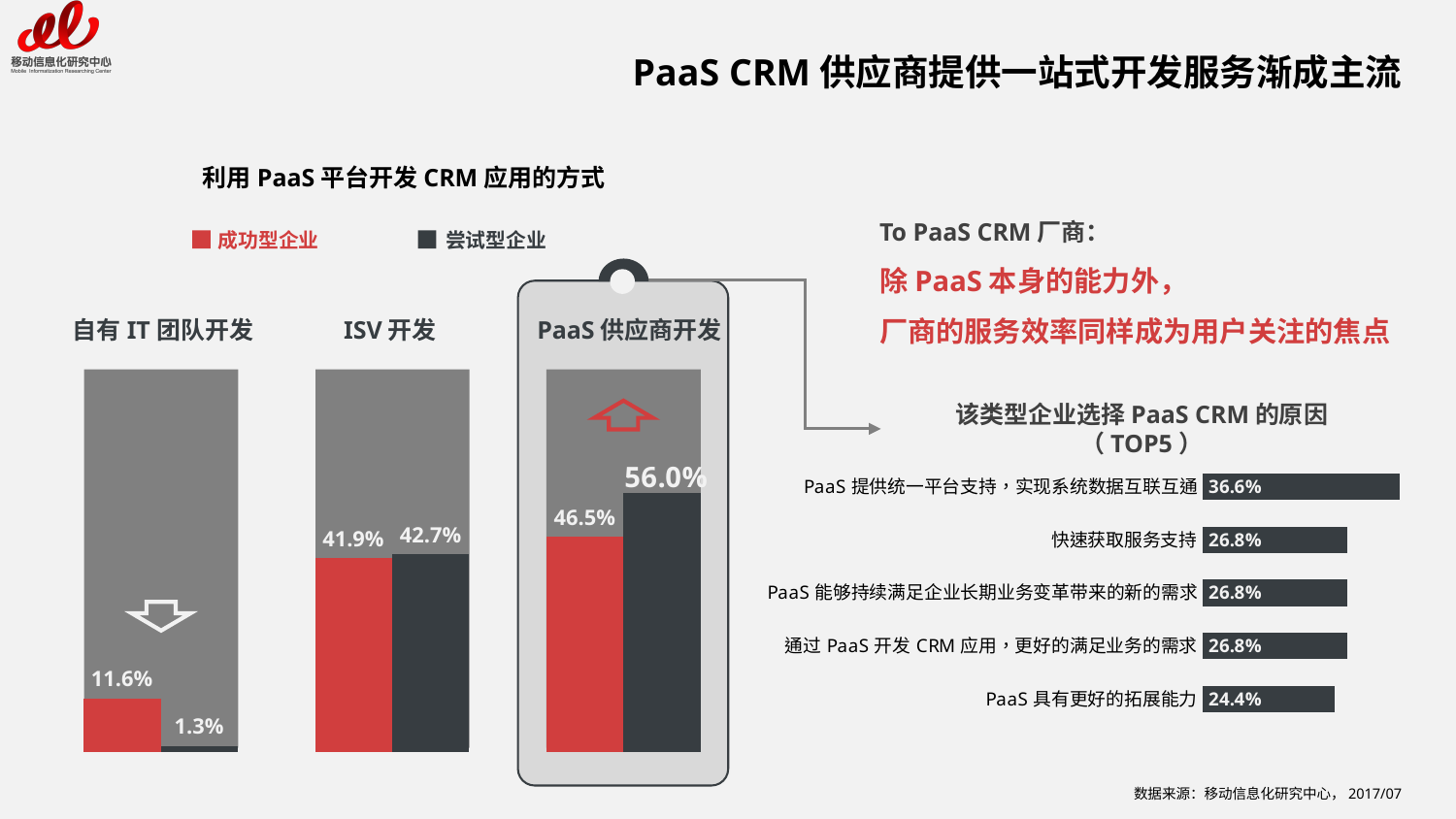
How many reasons are shown in the chart '该类型企业选择 PaaS CRM 的原因（TOP5）'? 5 In the chart '该类型企业选择 PaaS CRM 的原因（TOP5）', what is the difference between the highest value and the lowest value? 12.2% In the chart '利用 PaaS 平台开发 CRM 应用的方式', what is the difference between 尝试型企业 and 成功型企业 under PaaS 供应商开发? 9.5% In the chart '利用 PaaS 平台开发 CRM 应用的方式', what is the value for 尝试型企业 under ISV 开发? 42.7% In the chart '利用 PaaS 平台开发 CRM 应用的方式', what is the value for 成功型企业 under 自有 IT 团队开发? 11.6% In the chart '利用 PaaS 平台开发 CRM 应用的方式', which development method has the lowest value for 尝试型企业? 自有 IT 团队开发 How many series does the legend of the chart '利用 PaaS 平台开发 CRM 应用的方式' list? 2 In the chart '该类型企业选择 PaaS CRM 的原因（TOP5）', what is the value for 'PaaS 提供统一平台支持，实现系统数据互联互通'? 36.6% What kind of chart is '利用 PaaS 平台开发 CRM 应用的方式'? Bar chart In the chart '利用 PaaS 平台开发 CRM 应用的方式', which is larger under 自有 IT 团队开发: 成功型企业 or 尝试型企业? 成功型企业 In the chart '该类型企业选择 PaaS CRM 的原因（TOP5）', which reason has the lowest value? PaaS 具有更好的拓展能力 In the chart '利用 PaaS 平台开发 CRM 应用的方式', what is the value for 尝试型企业 under PaaS 供应商开发? 56.0%